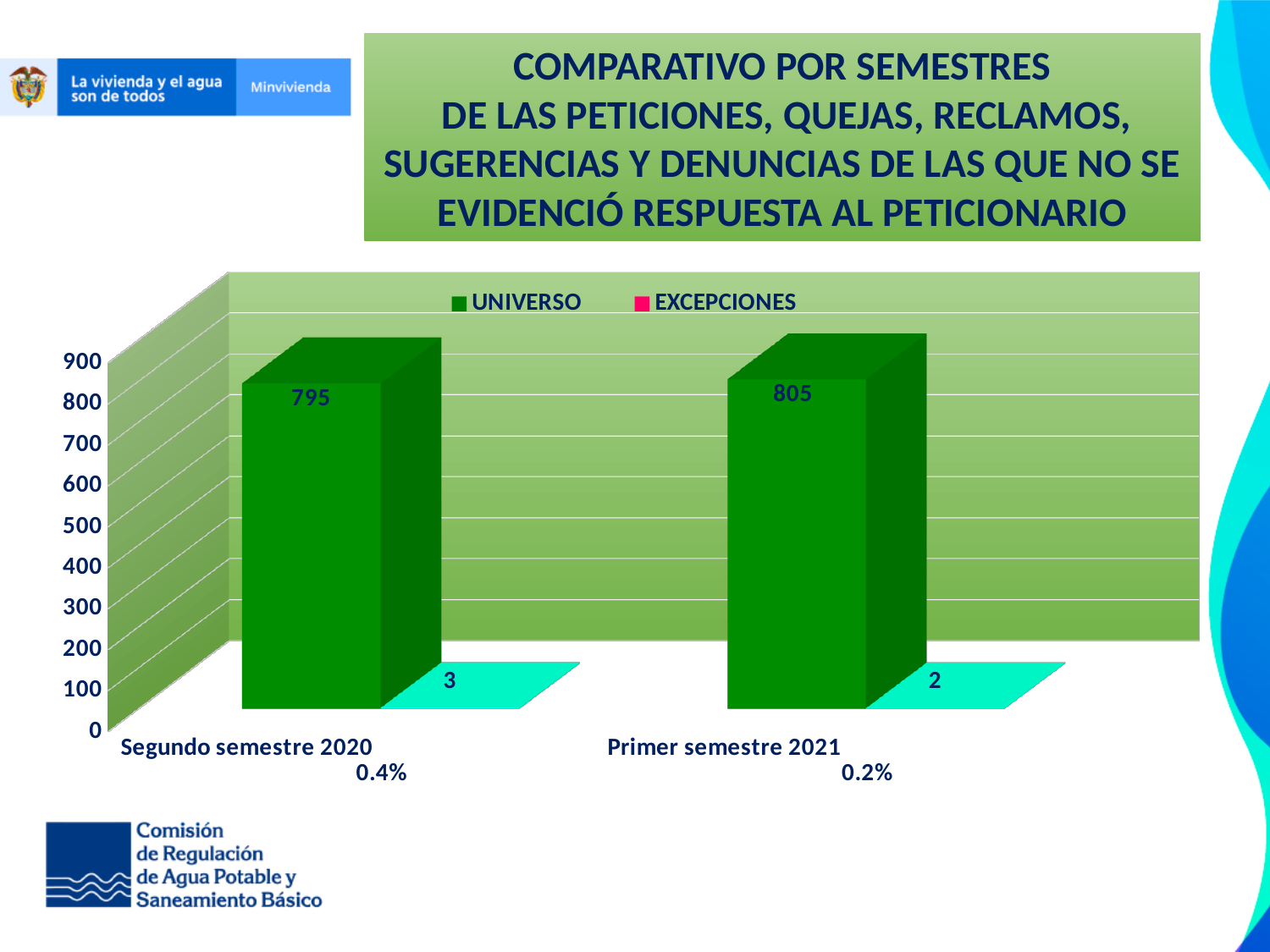
Which semester has the higher UNIVERSO value? Primer semestre 2021 How many categories are shown on the x axis? 2 What is the EXCEPCIONES value for Primer semestre 2021? 2 Which semester has the lower EXCEPCIONES value? Primer semestre 2021 What is the EXCEPCIONES value for Segundo semestre 2020? 3 Is the EXCEPCIONES value for Segundo semestre 2020 larger or smaller than that for Primer semestre 2021? larger What is the UNIVERSO value for Segundo semestre 2020? 795 What percentage is printed below the Segundo semestre 2020 category? 0.4% What kind of chart is shown on the slide? bar chart What is the difference between the UNIVERSO values for Primer semestre 2021 and Segundo semestre 2020? 10 How many series does the legend list? 2 What is the UNIVERSO value for Primer semestre 2021? 805